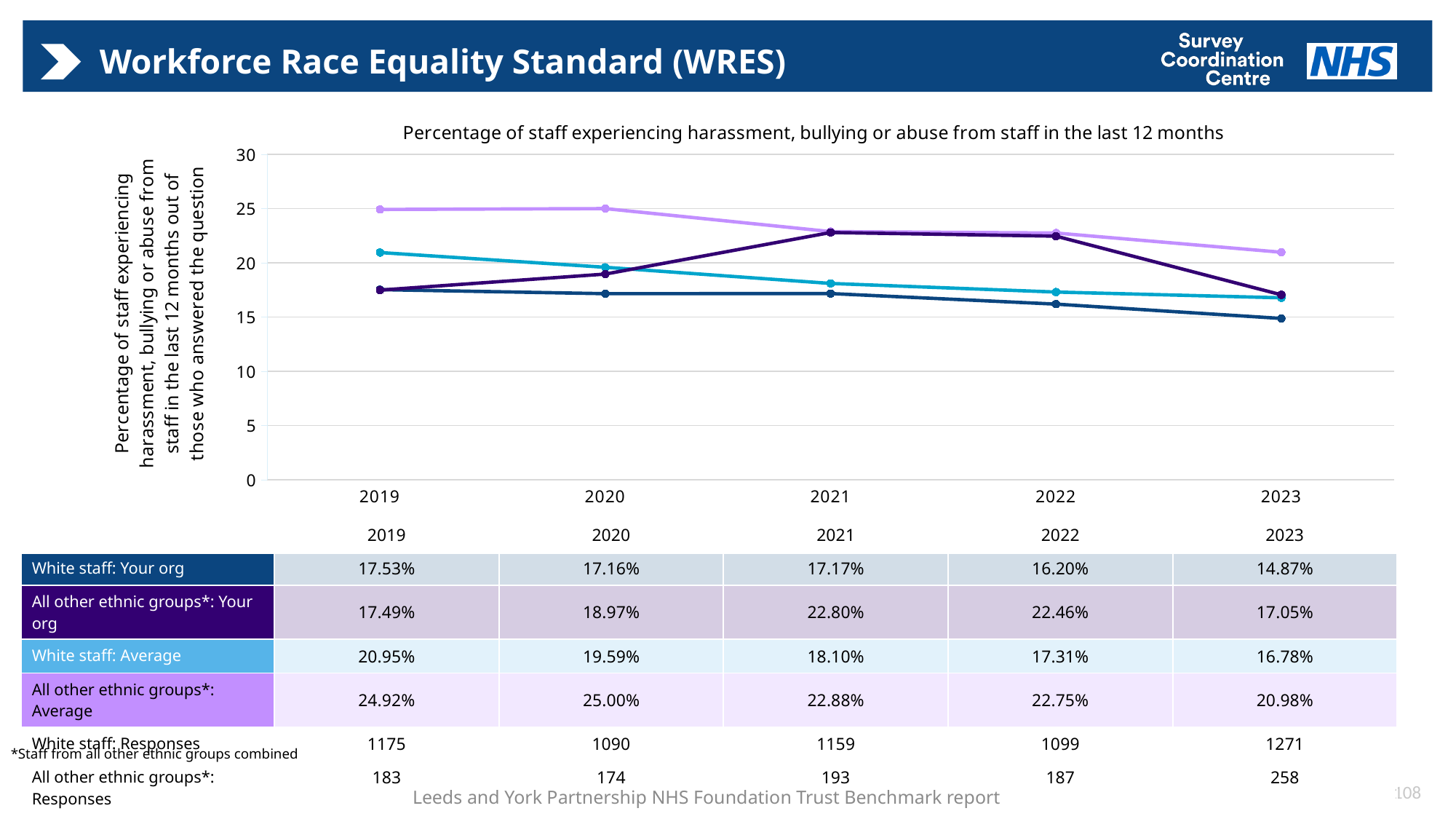
What kind of chart is shown on the slide? Line chart In which year is the value for All other ethnic groups*: Your org highest? 2021 Which is larger in 2020: White staff: Average or All other ethnic groups*: Your org? White staff: Average What is the value for White staff: Your org in 2023? 14.87% How many years are plotted on the x axis? 5 What is the value for White staff: Average in 2021? 18.10% What is the value for All other ethnic groups*: Average in 2020? 25.00% Does the value for White staff: Average rise or fall from 2019 to 2023? Fall In which year is the value for White staff: Your org lowest? 2023 What is the difference between All other ethnic groups*: Average and White staff: Average in 2023? 4.20 percentage points Is the value for All other ethnic groups*: Average in 2019 greater or less than 20? greater How many series are plotted on the chart? 4